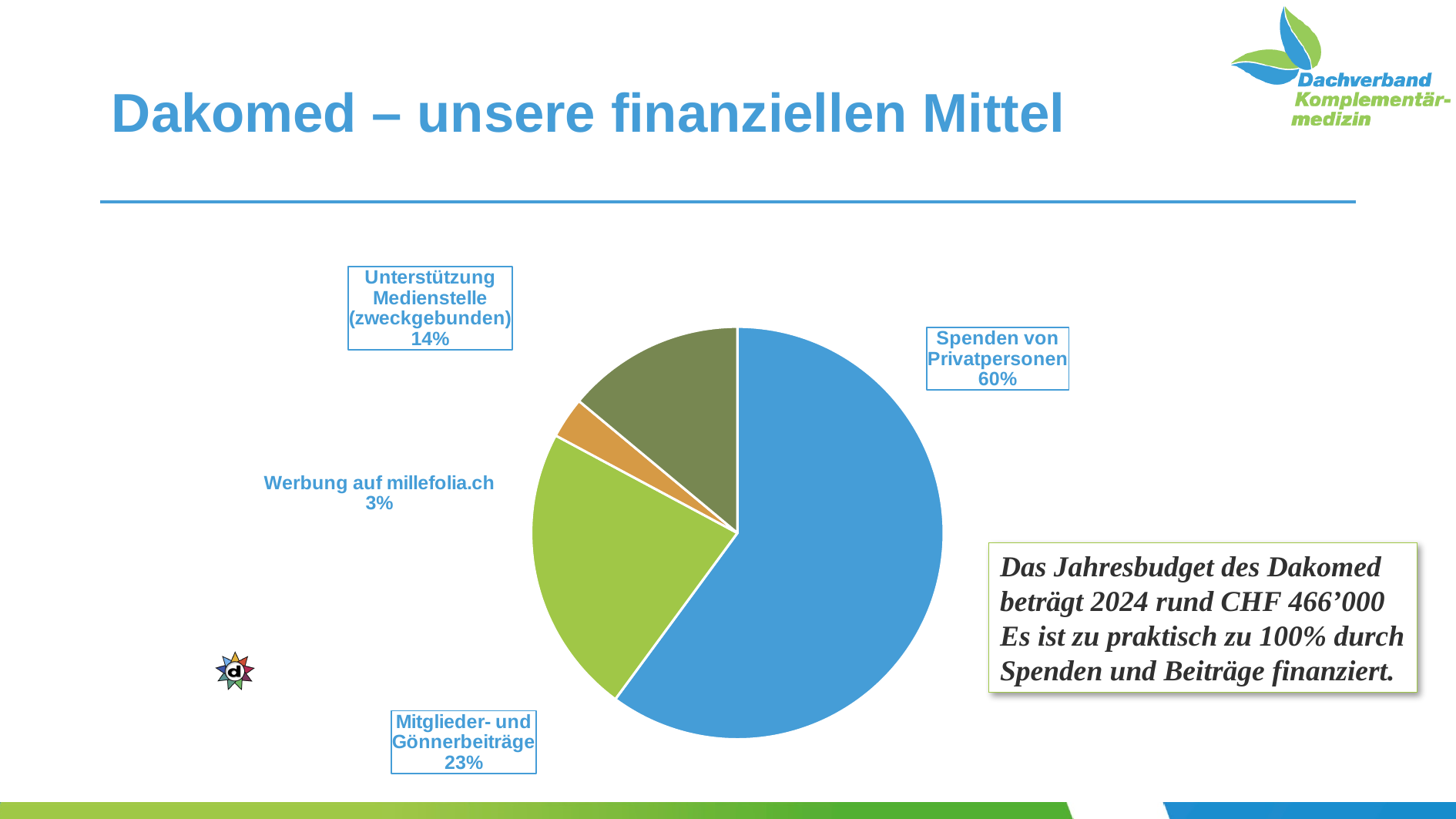
What share of the pie is Werbung auf millefolia.ch? 3% How many slices does the pie chart have? 4 What is the difference in percentage points between Spenden von Privatpersonen and Mitglieder- und Gönnerbeiträge? 37 percentage points Which category has the largest share of the pie? Spenden von Privatpersonen What share of the pie is Mitglieder- und Gönnerbeiträge? 23% What kind of chart is shown on the slide? pie chart What share of the pie is Spenden von Privatpersonen? 60% Which category has the smallest share of the pie? Werbung auf millefolia.ch What is the difference in percentage points between Unterstützung Medienstelle (zweckgebunden) and Werbung auf millefolia.ch? 11 percentage points Which is larger: Mitglieder- und Gönnerbeiträge or Unterstützung Medienstelle (zweckgebunden)? Mitglieder- und Gönnerbeiträge What is the title of the slide containing the pie chart? Dakomed – unsere finanziellen Mittel